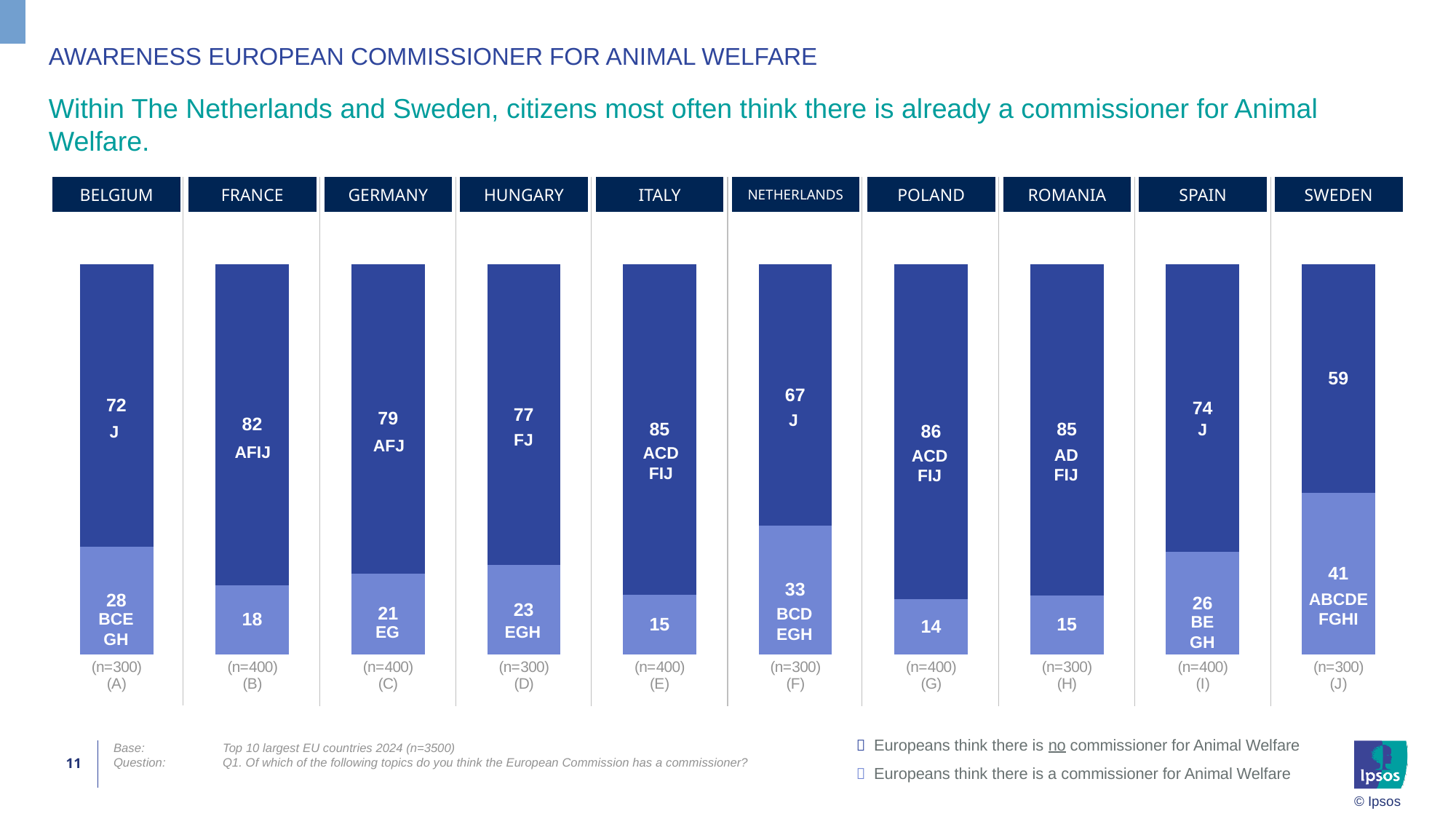
Which country has the highest share of citizens who think there is no commissioner for Animal Welfare? Poland What kind of chart is shown on the slide? Stacked bar chart What value is shown for the 'no commissioner' (darker) segment of the Italy bar? 85 What is the difference between Sweden's and the Netherlands' shares of citizens who think there is a commissioner for Animal Welfare? 8 What percentage of respondents in Sweden think there is a commissioner for Animal Welfare (the lighter segment)? 41 Which has a larger share of citizens who think there is a commissioner for Animal Welfare, Belgium or Spain? Belgium Which country has the lowest share of citizens who think there is a commissioner for Animal Welfare? Poland What value is shown for the 'no commissioner' (darker) segment of the Poland bar? 86 Which country has the highest share of citizens who think there is a commissioner for Animal Welfare? Sweden How many series does the legend list? 2 How many countries are shown in the chart? 10 What is the total of the two segments of the Belgium bar? 100